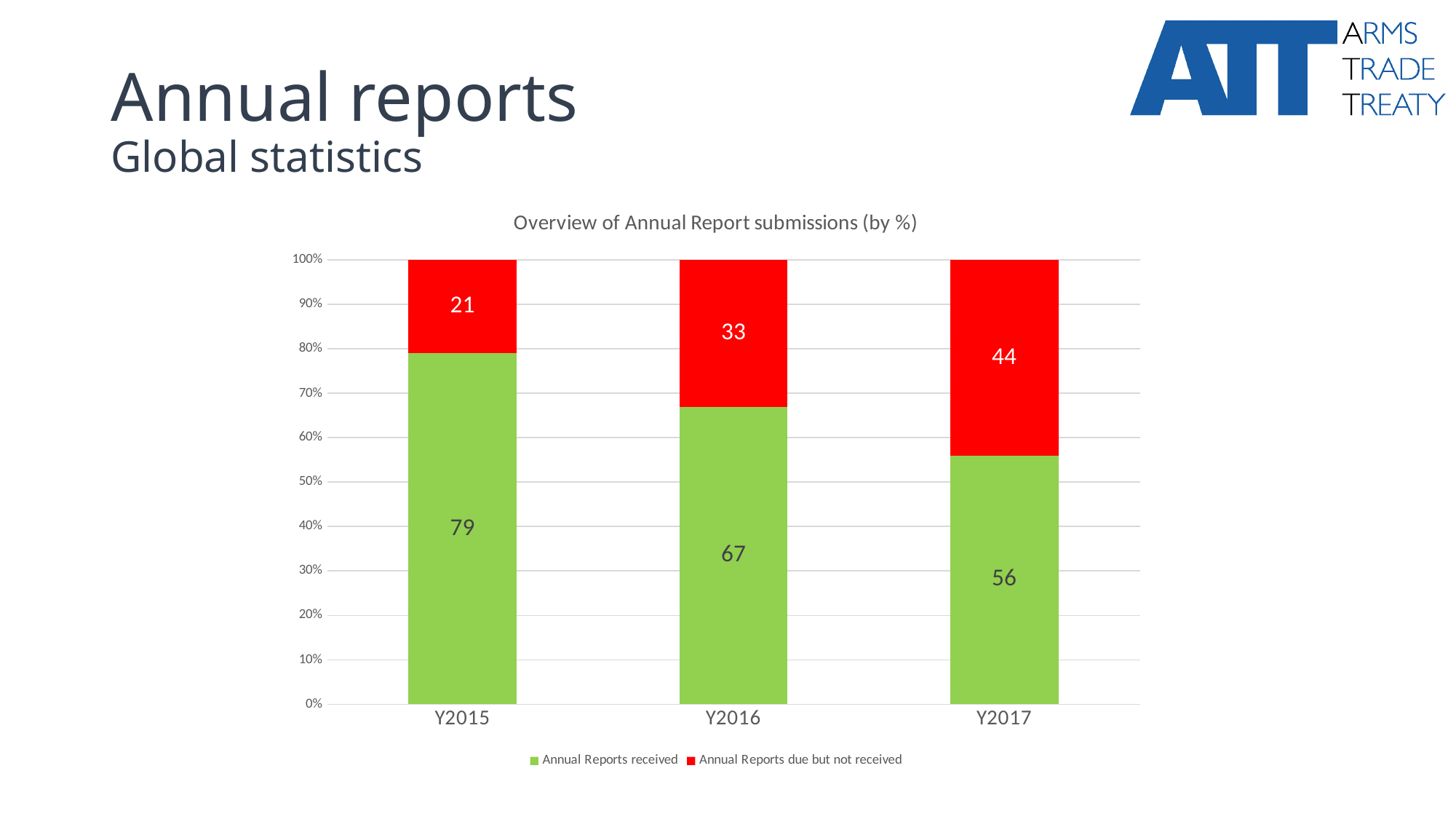
What is the value for Annual Reports received in Y2015? 79 Which is larger: Annual Reports due but not received in Y2016 or in Y2017? Y2017 What is the difference between Annual Reports received in Y2015 and Y2017? 23 Which year has the highest value for Annual Reports received? Y2015 What is the title of the chart? Overview of Annual Report submissions (by %) What is the value for Annual Reports due but not received in Y2017? 44 Which year has the lowest value for Annual Reports due but not received? Y2015 Do the values for Annual Reports received rise or fall from Y2015 to Y2017? Fall How many years are shown on the x axis? 3 How many series does the legend list? 2 What is the value for Annual Reports received in Y2016? 67 What kind of chart is shown on the slide? Stacked bar chart